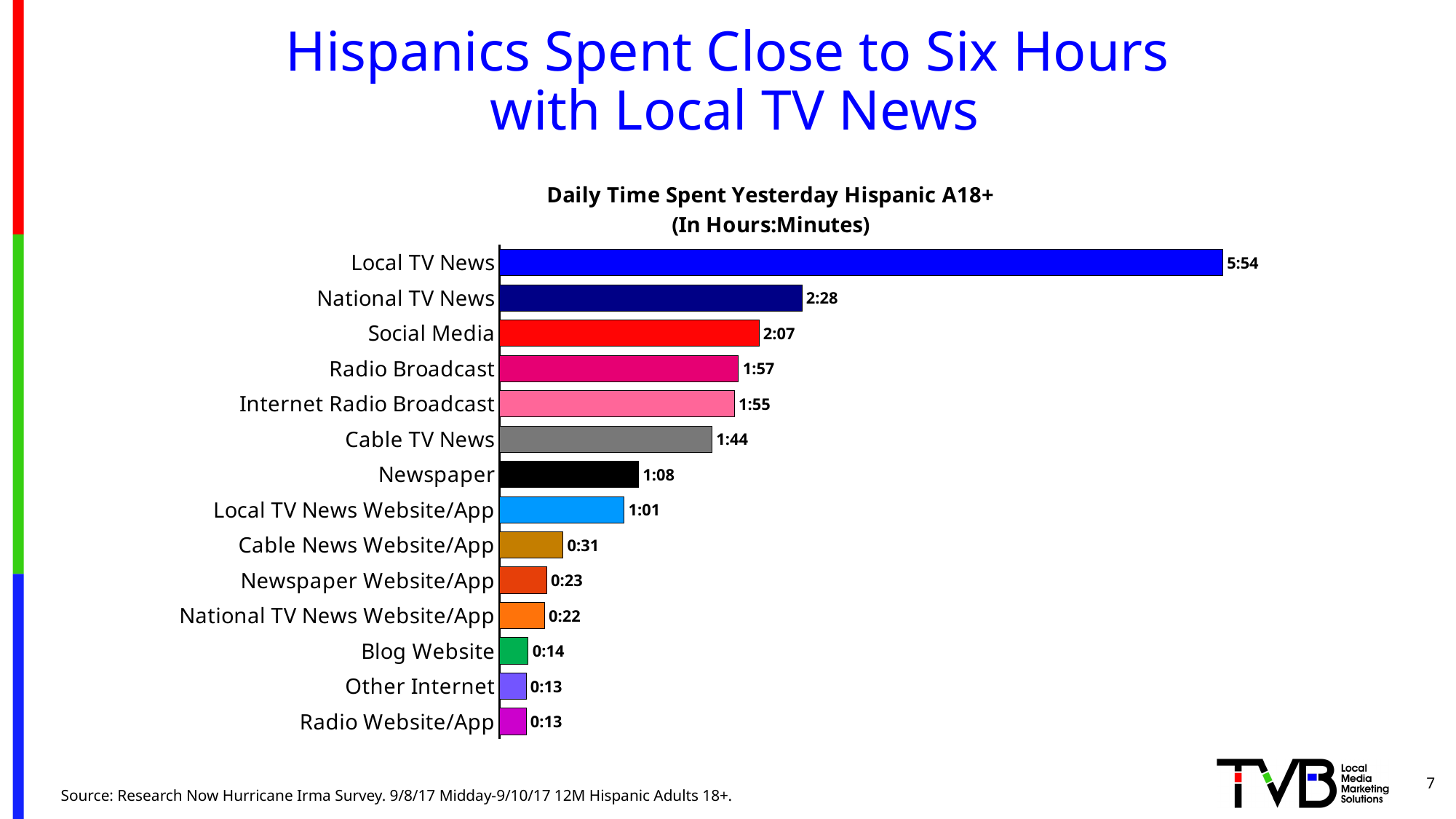
What is the daily time spent on Local TV News? 5:54 What is the difference between the time spent on Local TV News and National TV News? 3:26 What kind of chart is shown on the slide? Bar chart What is the difference between Newspaper and Local TV News Website/App? 0:07 How many categories are shown in the chart? 14 What is the title of the chart? Daily Time Spent Yesterday Hispanic A18+ (In Hours:Minutes) Which category has the highest daily time spent? Local TV News How much time was spent on Cable News Website/App? 0:31 What is the value for Internet Radio Broadcast? 1:55 Which is larger, the value for Radio Broadcast or the value for Cable TV News? Radio Broadcast What is the value shown for Social Media? 2:07 Which is larger, the value for Newspaper Website/App or the value for Blog Website? Newspaper Website/App